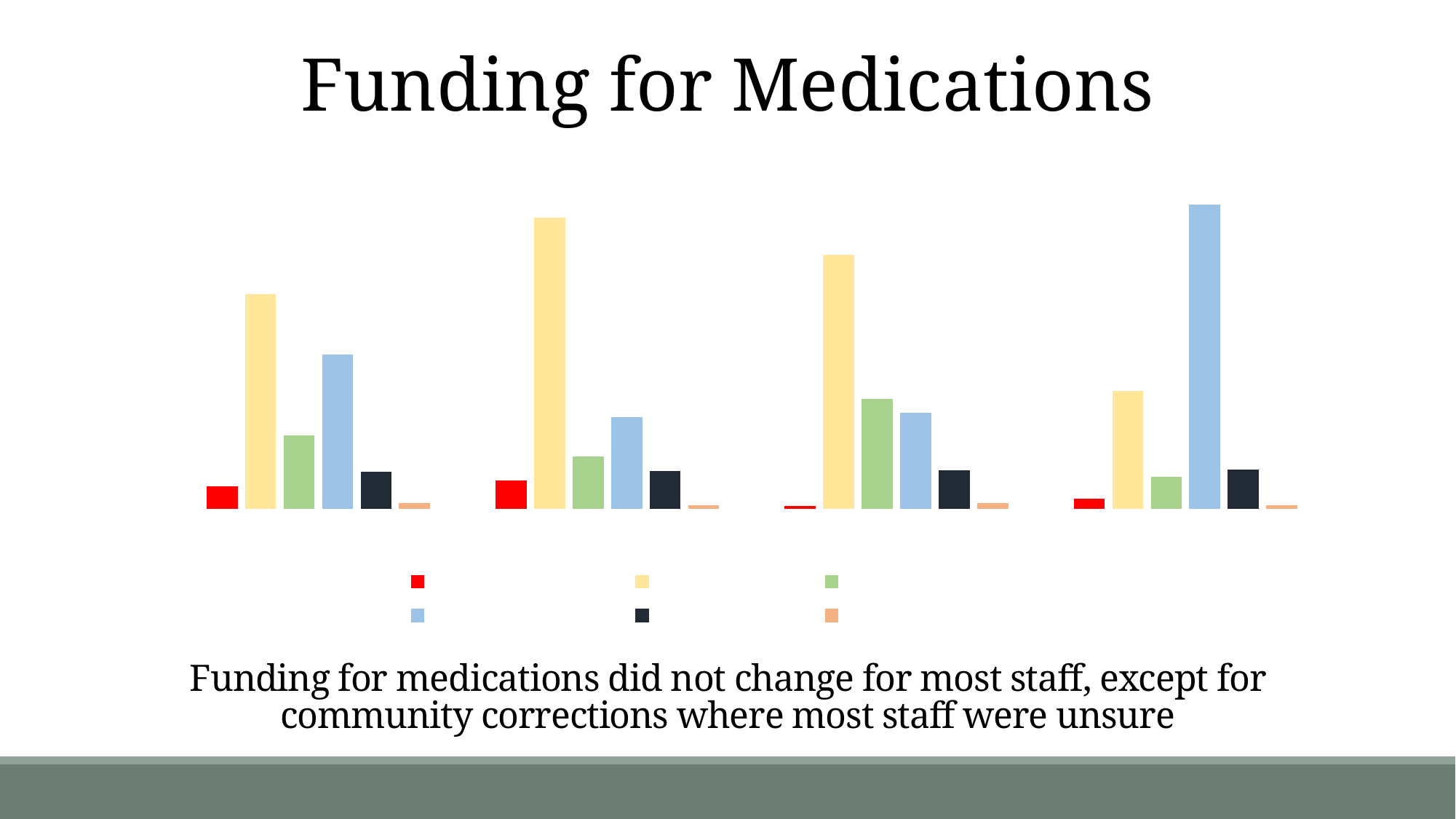
In the leftmost group of bars, which colour bar is the shortest? orange How many bars are in each group of the chart? 6 How many colour swatches does the legend below the chart show? 6 How many groups of bars does the chart contain? 4 What kind of chart is shown on the slide? bar chart In the rightmost group of bars, which colour bar is the tallest? light blue What is the title of the slide containing the chart? Funding for Medications In the second group from the left, which is taller: the yellow bar or the light blue bar? yellow In the leftmost group of bars, which colour bar is the tallest? yellow In the rightmost group, which is taller: the yellow bar or the light blue bar? light blue In the second group from the left, which colour bar is the tallest? yellow In the leftmost group, which is taller: the red bar or the dark navy bar? dark navy